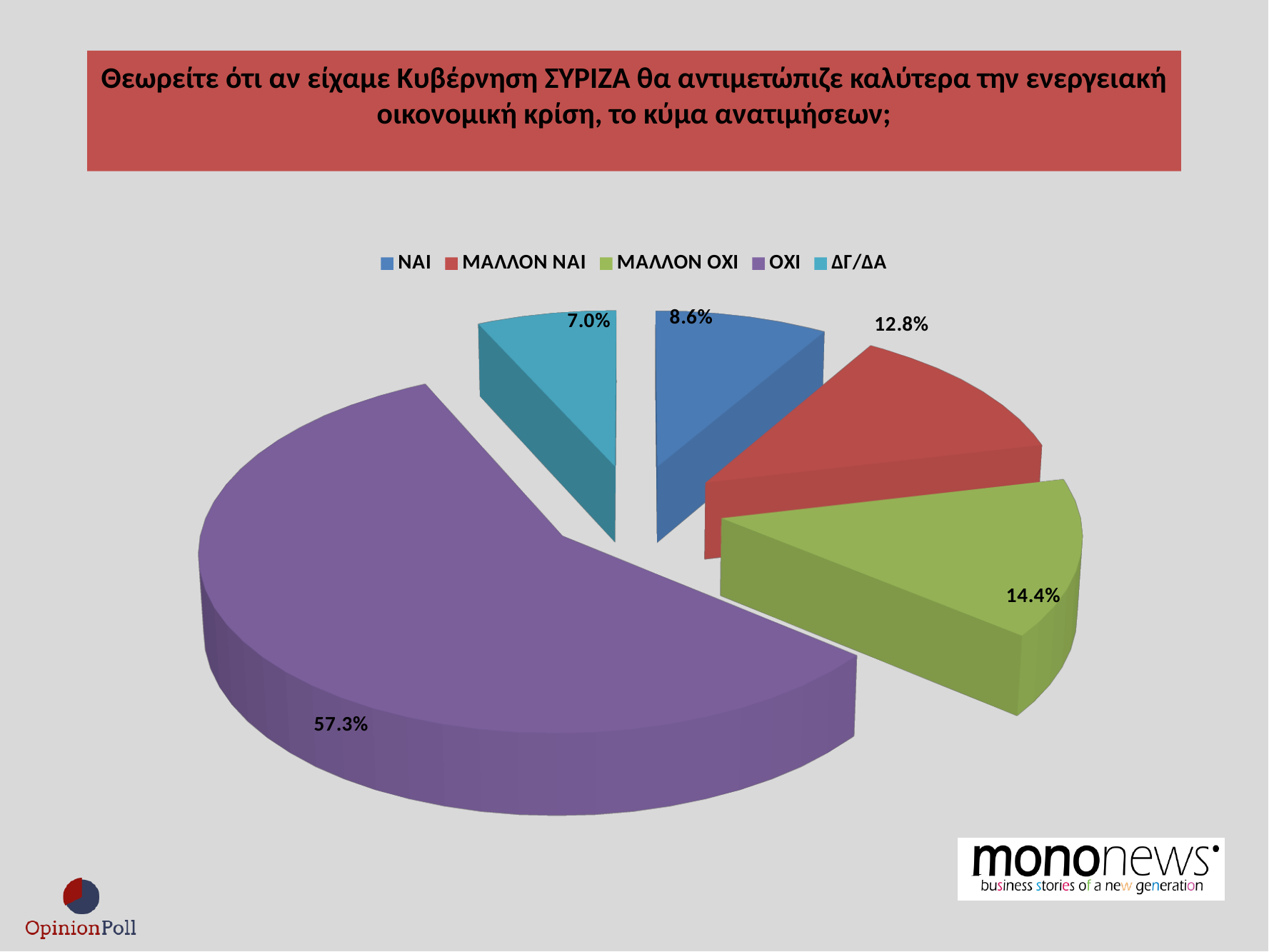
How many categories does the pie chart show? 5 Which response category has the largest share of the pie? ΟΧΙ What percentage of respondents answered ΜΑΛΛΟΝ ΟΧΙ? 14.4% What is the difference in percentage points between ΟΧΙ and ΜΑΛΛΟΝ ΟΧΙ? 42.9 What colour is the ΟΧΙ slice in the pie chart? Purple What percentage of respondents answered ΝΑΙ? 8.6% Which is larger, the share for ΜΑΛΛΟΝ ΝΑΙ or the share for ΜΑΛΛΟΝ ΟΧΙ? ΜΑΛΛΟΝ ΟΧΙ What percentage of respondents answered ΟΧΙ? 57.3% What percentage of respondents answered ΜΑΛΛΟΝ ΝΑΙ? 12.8% What kind of chart is shown on the slide? Pie chart What percentage of respondents answered ΔΓ/ΔΑ? 7.0% Which response category has the smallest share of the pie? ΔΓ/ΔΑ